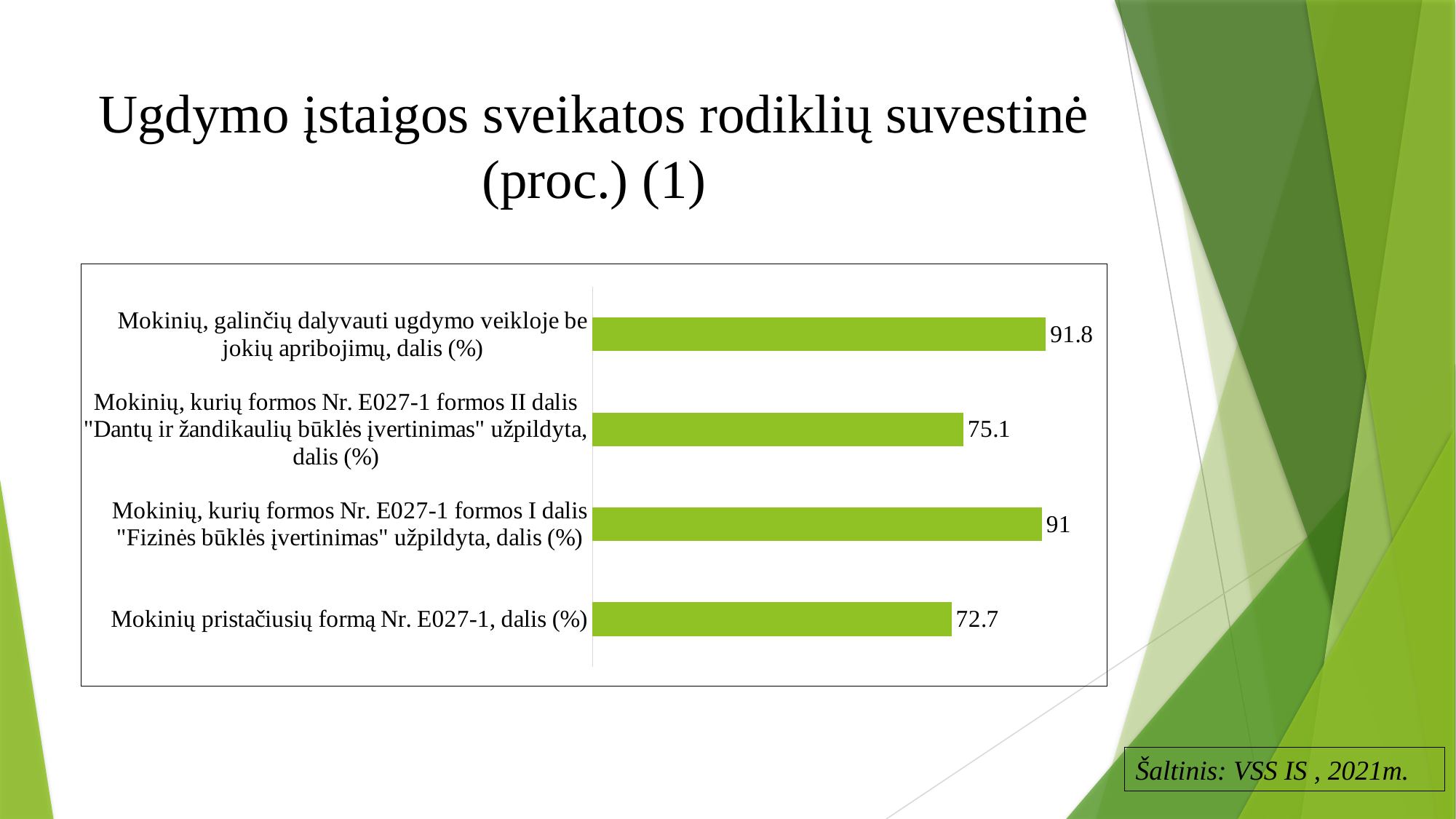
Which is larger: the value for the form I part ("Fizinės būklės įvertinimas") or the value for the form II part ("Dantų ir žandikaulių būklės įvertinimas")? Form I part ("Fizinės būklės įvertinimas"), 91 What is the value for "Mokinių, galinčių dalyvauti ugdymo veikloje be jokių apribojimų, dalis (%)"? 91.8 What is the difference between the value for "Mokinių, galinčių dalyvauti ugdymo veikloje be jokių apribojimų, dalis (%)" and the value for "Mokinių pristačiusių formą Nr. E027-1, dalis (%)"? 19.1 What is the value for "Mokinių, kurių formos Nr. E027-1 formos I dalis "Fizinės būklės įvertinimas" užpildyta, dalis (%)"? 91 How many categories are shown in the chart? 4 What is the value for "Mokinių pristačiusių formą Nr. E027-1, dalis (%)"? 72.7 What is the title of the slide? Ugdymo įstaigos sveikatos rodiklių suvestinė (proc.) (1) What is the difference between the value for the form II part ("Dantų ir žandikaulių būklės įvertinimas") and the value for "Mokinių pristačiusių formą Nr. E027-1, dalis (%)"? 2.4 What is the value for "Mokinių, kurių formos Nr. E027-1 formos II dalis "Dantų ir žandikaulių būklės įvertinimas" užpildyta, dalis (%)"? 75.1 Which category has the highest value? Mokinių, galinčių dalyvauti ugdymo veikloje be jokių apribojimų, dalis (%) What kind of chart is shown on the slide? Bar chart Which category has the lowest value? Mokinių pristačiusių formą Nr. E027-1, dalis (%)